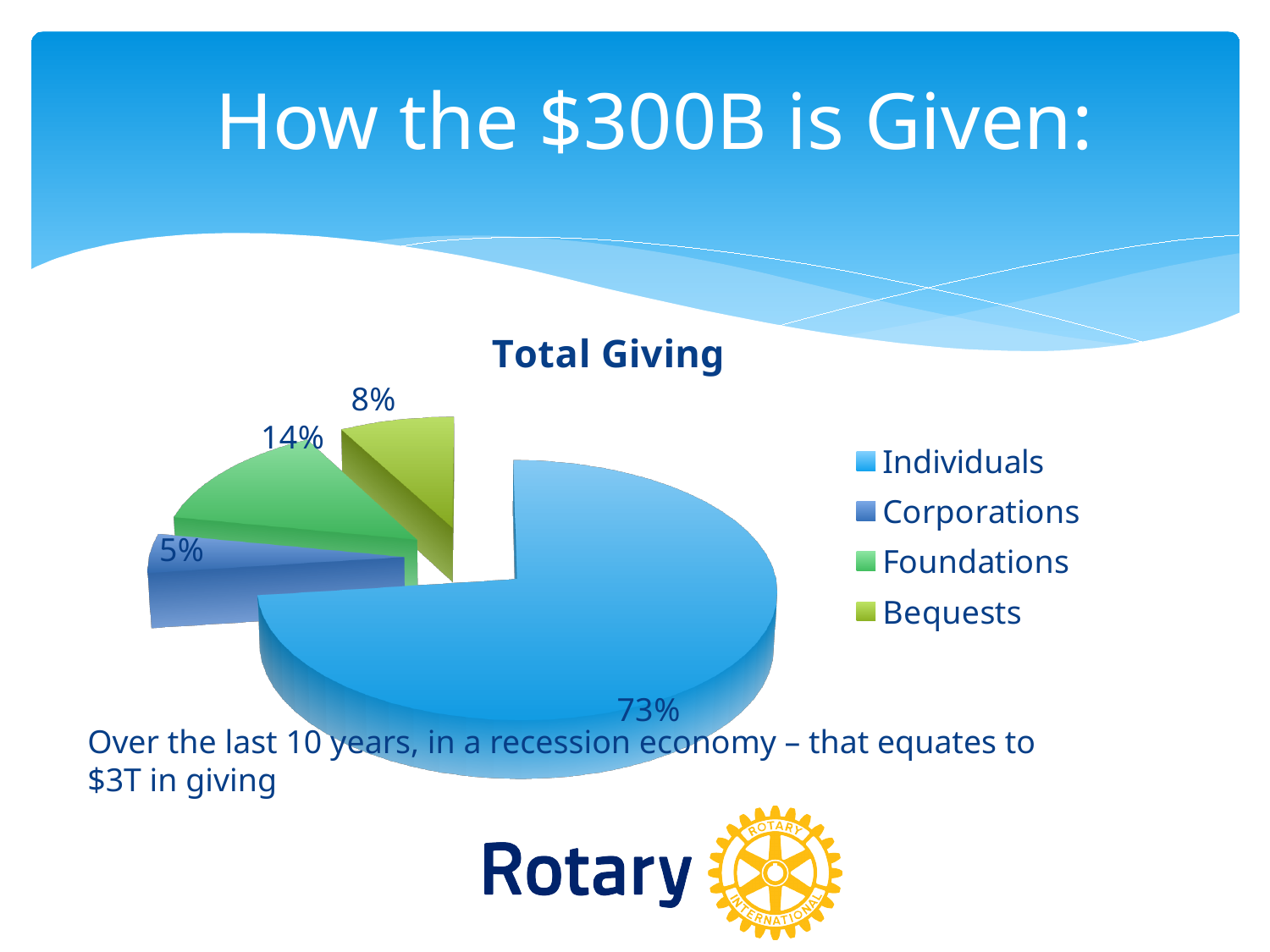
What is the title of the chart on the slide? Total Giving Which is larger, the share for Bequests or the share for Corporations? Bequests How many percentage points larger is the Individuals share than the Foundations share? 59% What share of Total Giving comes from Foundations? 14% Which category has the smallest share of Total Giving? Corporations Which category has the largest share of Total Giving? Individuals What share of Total Giving comes from Individuals? 73% How many percentage points larger is the Foundations share than the Bequests share? 6% How many categories are shown in the Total Giving pie chart? 4 What kind of chart is used to show Total Giving? Pie chart What share of Total Giving comes from Bequests? 8% What share of Total Giving comes from Corporations? 5%